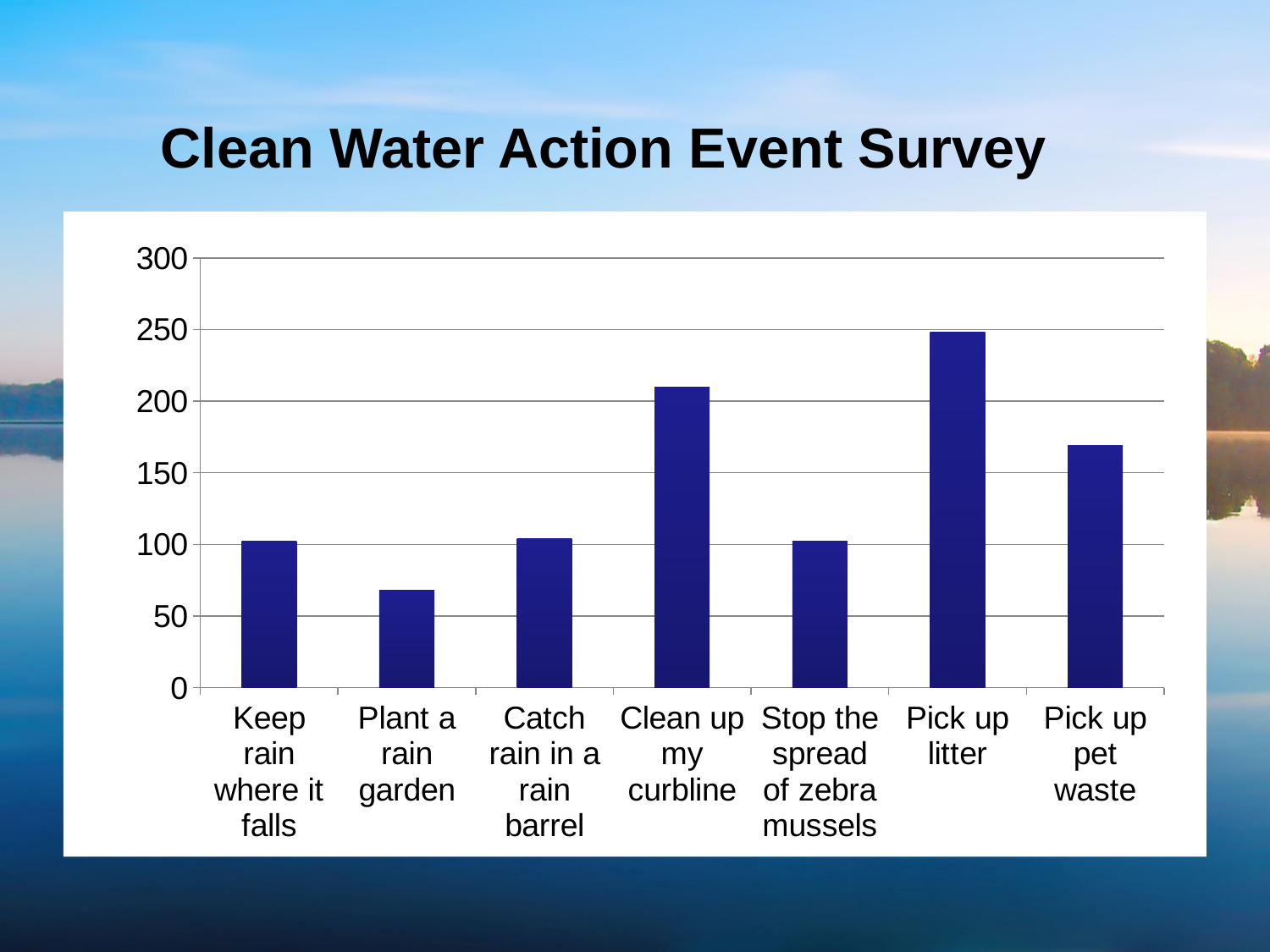
Which is larger: the value for Pick up litter or the value for Clean up my curbline? Pick up litter Which category has the highest value in the chart? Pick up litter Is the value for Catch rain in a rain barrel greater or less than 150? less What kind of chart is shown on the slide? Bar chart Is the value for Stop the spread of zebra mussels greater or less than 150? less Is the value for Pick up litter greater or less than 200? greater What is the title shown above the chart on the slide? Clean Water Action Event Survey How many categories are shown on the x axis of the chart? 7 Which category has the lowest value in the chart? Plant a rain garden Which is larger: the value for Clean up my curbline or the value for Pick up pet waste? Clean up my curbline